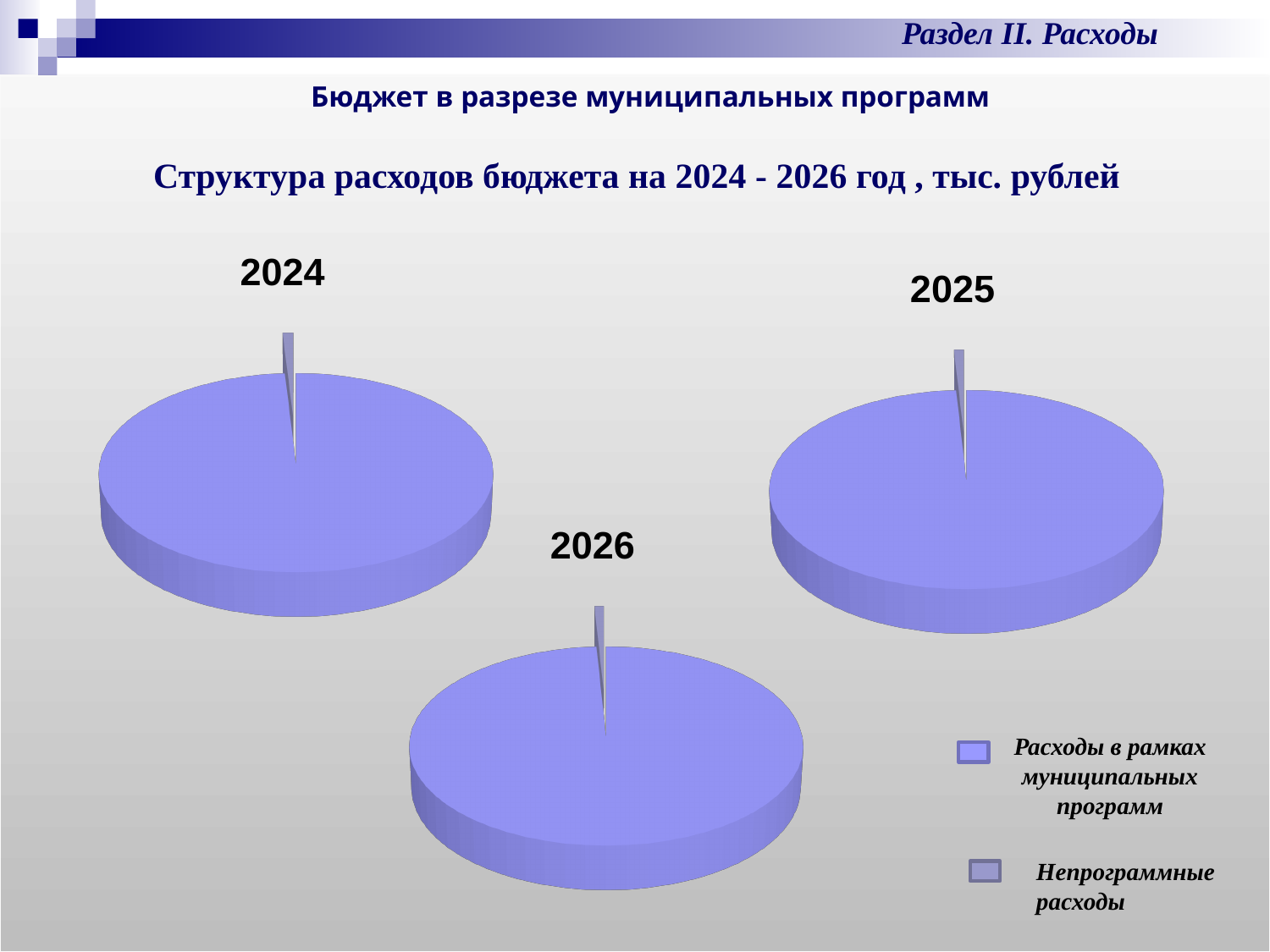
In the 2024 pie chart, which category has the larger slice: Расходы в рамках муниципальных программ or Непрограммные расходы? Расходы в рамках муниципальных программ How many pie charts are shown on the slide? 3 How many categories does the legend list? 2 What kind of chart is used for the 2024 data on this slide? Pie chart In the 2026 pie chart, which category takes up the largest share? Расходы в рамках муниципальных программ In the 2026 pie chart, is the share of Расходы в рамках муниципальных программ greater or less than 50%? greater In the 2025 pie chart, is the share of Непрограммные расходы greater or less than 50%? less In the 2025 pie chart, which category has the smaller slice? Непрограммные расходы How many slices does each pie chart on the slide contain? 2 Which years do the three pie charts on the slide represent? 2024, 2025, 2026 What is the title of the chart group on the slide? Структура расходов бюджета на 2024 - 2026 год , тыс. рублей